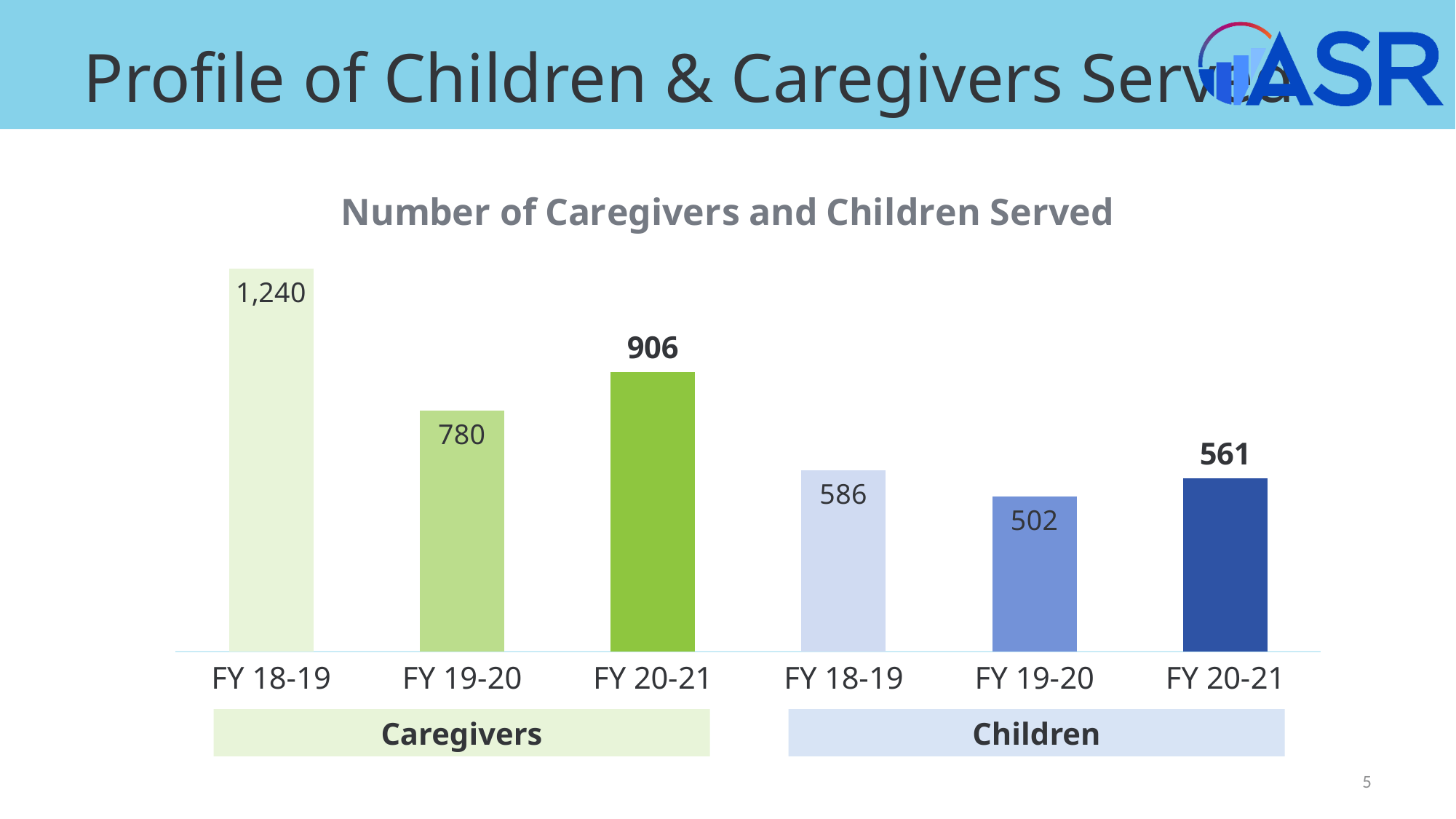
What is the number of children served in FY 19-20? 502 Which is larger: the number of children served in FY 18-19 or in FY 20-21? FY 18-19 What is the title of the chart? Number of Caregivers and Children Served What kind of chart is shown on the slide? Bar chart Which fiscal year has the highest number of caregivers served? FY 18-19 What is the difference between the number of children served in FY 20-21 and FY 19-20? 59 What is the number of caregivers served in FY 18-19? 1,240 Which fiscal year has the lowest number of children served? FY 19-20 What is the difference between the number of caregivers served in FY 18-19 and FY 19-20? 460 What is the number of caregivers served in FY 20-21? 906 How many bars are plotted in the chart? 6 What are the two groups labelled beneath the chart? Caregivers and Children